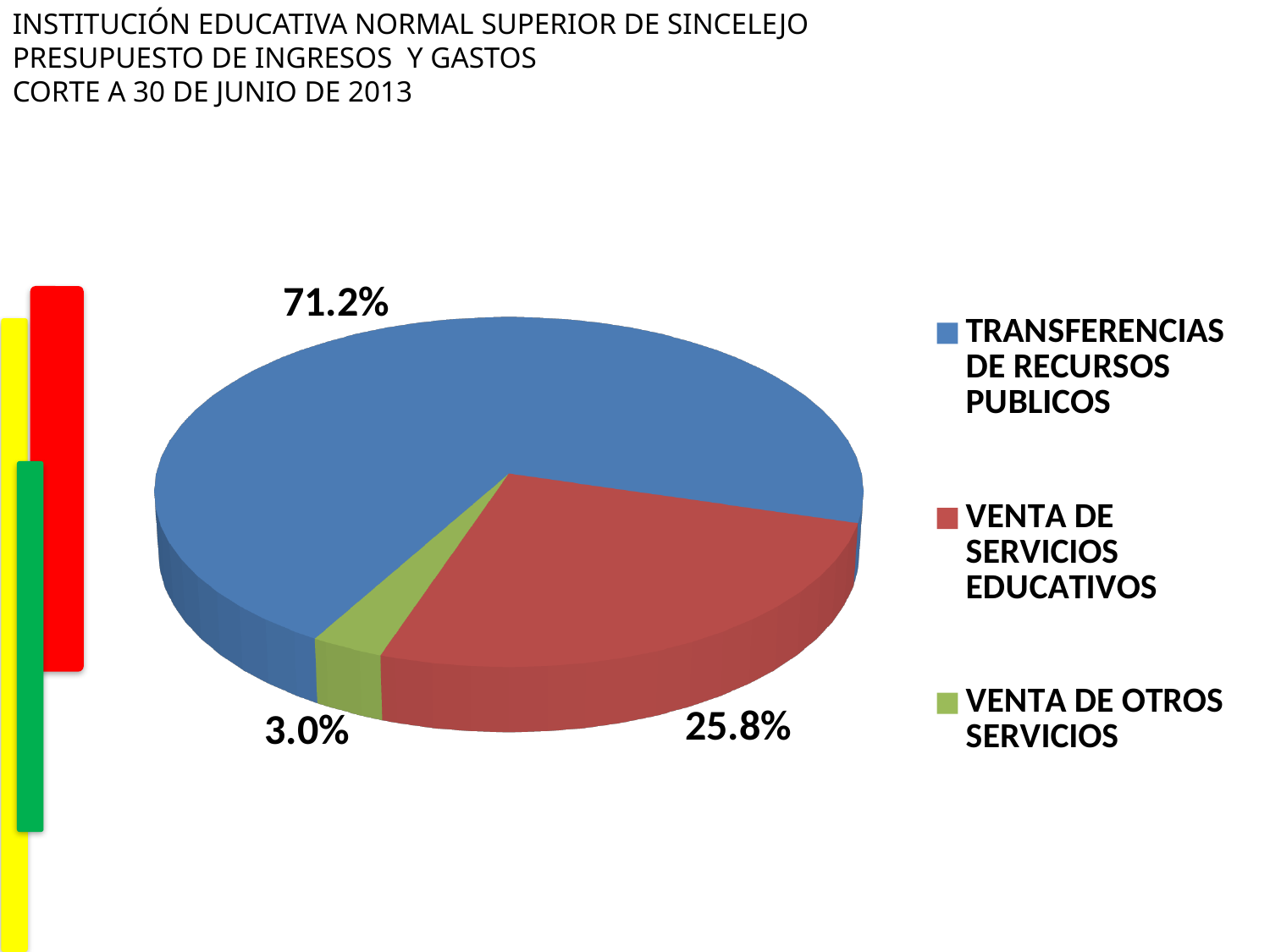
What share of the pie does TRANSFERENCIAS DE RECURSOS PUBLICOS represent? 71.2% What share of the pie does VENTA DE OTROS SERVICIOS represent? 3.0% Which category has the smallest slice of the pie? VENTA DE OTROS SERVICIOS Which is larger, the share for VENTA DE SERVICIOS EDUCATIVOS or the share for VENTA DE OTROS SERVICIOS? VENTA DE SERVICIOS EDUCATIVOS Which category has the largest slice of the pie? TRANSFERENCIAS DE RECURSOS PUBLICOS What colour is the slice for VENTA DE OTROS SERVICIOS? Green What kind of chart is shown on the slide? Pie chart How many slices does the pie chart have? 3 What is the difference in percentage points between VENTA DE SERVICIOS EDUCATIVOS and VENTA DE OTROS SERVICIOS? 22.8 How many entries does the legend list? 3 What share of the pie does VENTA DE SERVICIOS EDUCATIVOS represent? 25.8% What is the difference in percentage points between TRANSFERENCIAS DE RECURSOS PUBLICOS and VENTA DE SERVICIOS EDUCATIVOS? 45.4